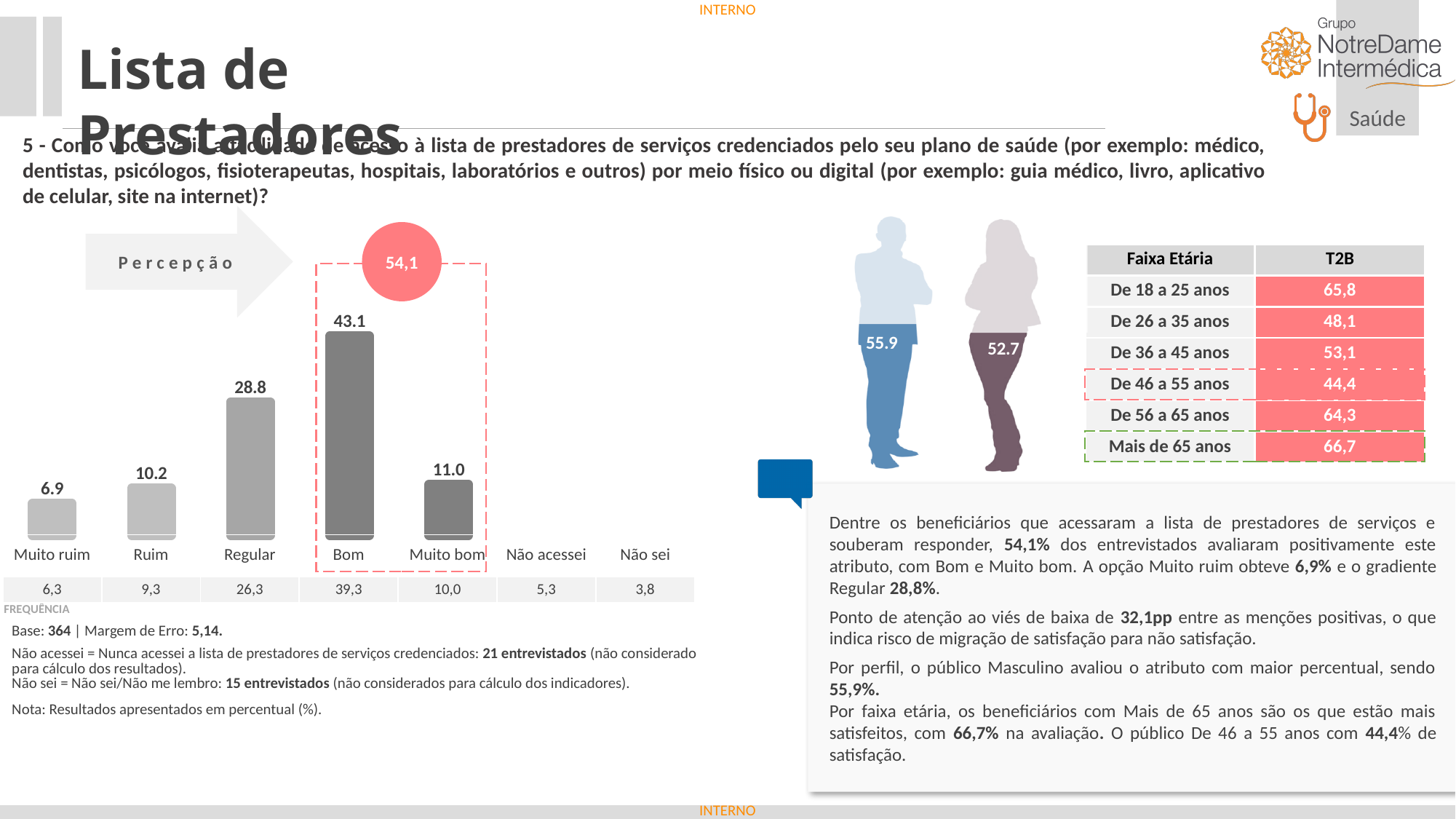
What is the combined value of Bom and Muito bom shown in the red circle above the chart? 54,1 What is the value for Regular in the bar chart? 28.8 What is the difference between the values for Ruim and Muito ruim? 3.3 Which category has the lowest plotted bar in the chart? Muito ruim What is the value for Muito bom in the bar chart? 11.0 Which is larger, the value for Ruim or the value for Muito bom? Muito bom What is the difference between the values for Bom and Regular? 14.3 What kind of chart is shown on the left of the slide? Bar chart How many categories are labelled on the x axis of the bar chart? 7 What is the value for Bom in the bar chart? 43.1 What is the value for Muito ruim in the bar chart? 6.9 Which category has the highest bar in the chart? Bom